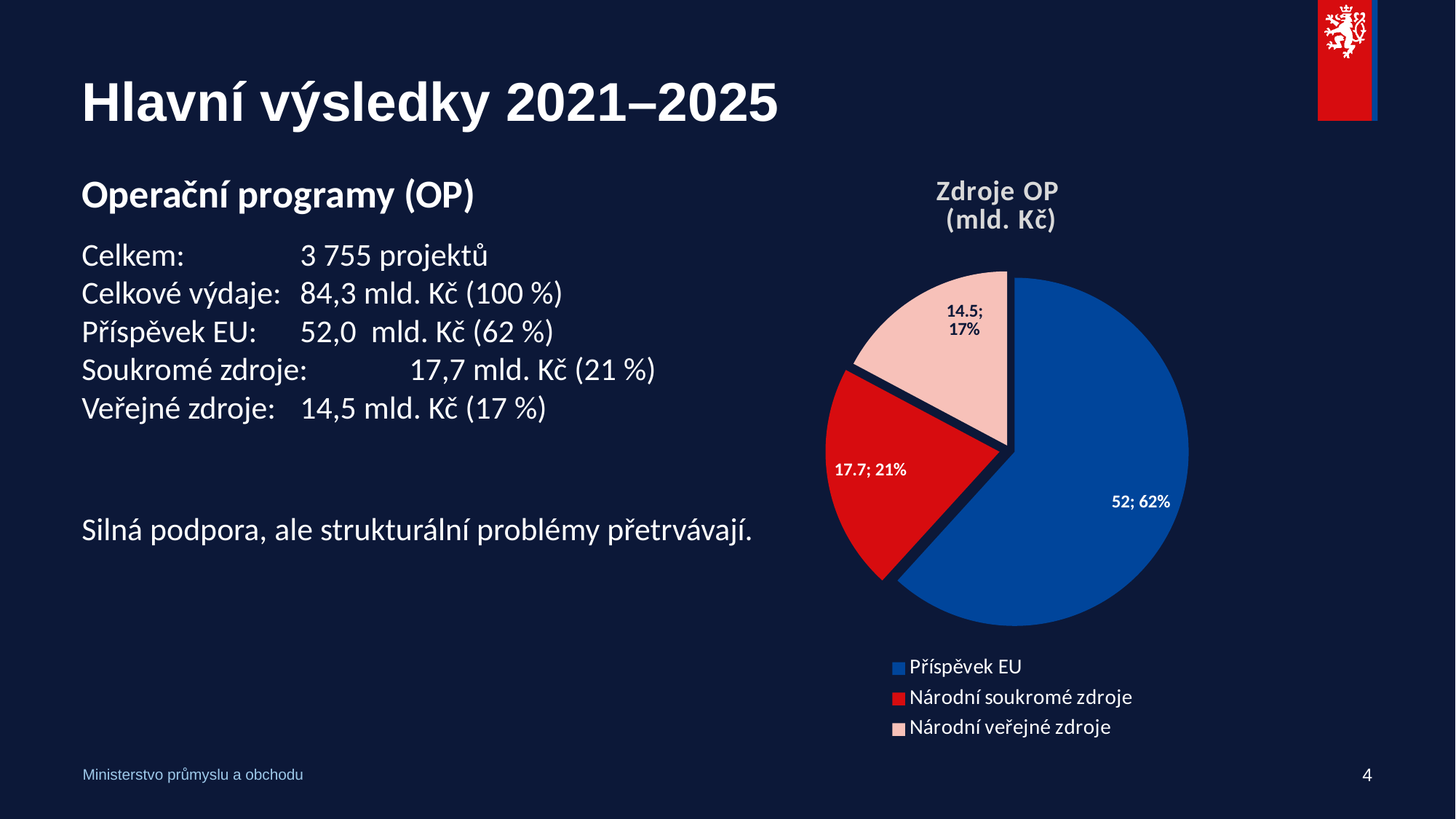
What is the value for Příspěvek EU in the chart? 52 Which is larger, the value for Národní soukromé zdroje or Národní veřejné zdroje? Národní soukromé zdroje Which category has the largest slice of the pie? Příspěvek EU What is the title of the chart? Zdroje OP (mld. Kč) What is the difference between the values for Národní soukromé zdroje and Národní veřejné zdroje? 3.2 How many categories does the legend list? 3 What share of the pie does Příspěvek EU represent? 62% What is the value for Národní soukromé zdroje in the chart? 17.7 What share of the pie does Národní veřejné zdroje represent? 17% What kind of chart is shown on the slide? pie chart What is the value for Národní veřejné zdroje in the chart? 14.5 Which category has the smallest slice of the pie? Národní veřejné zdroje